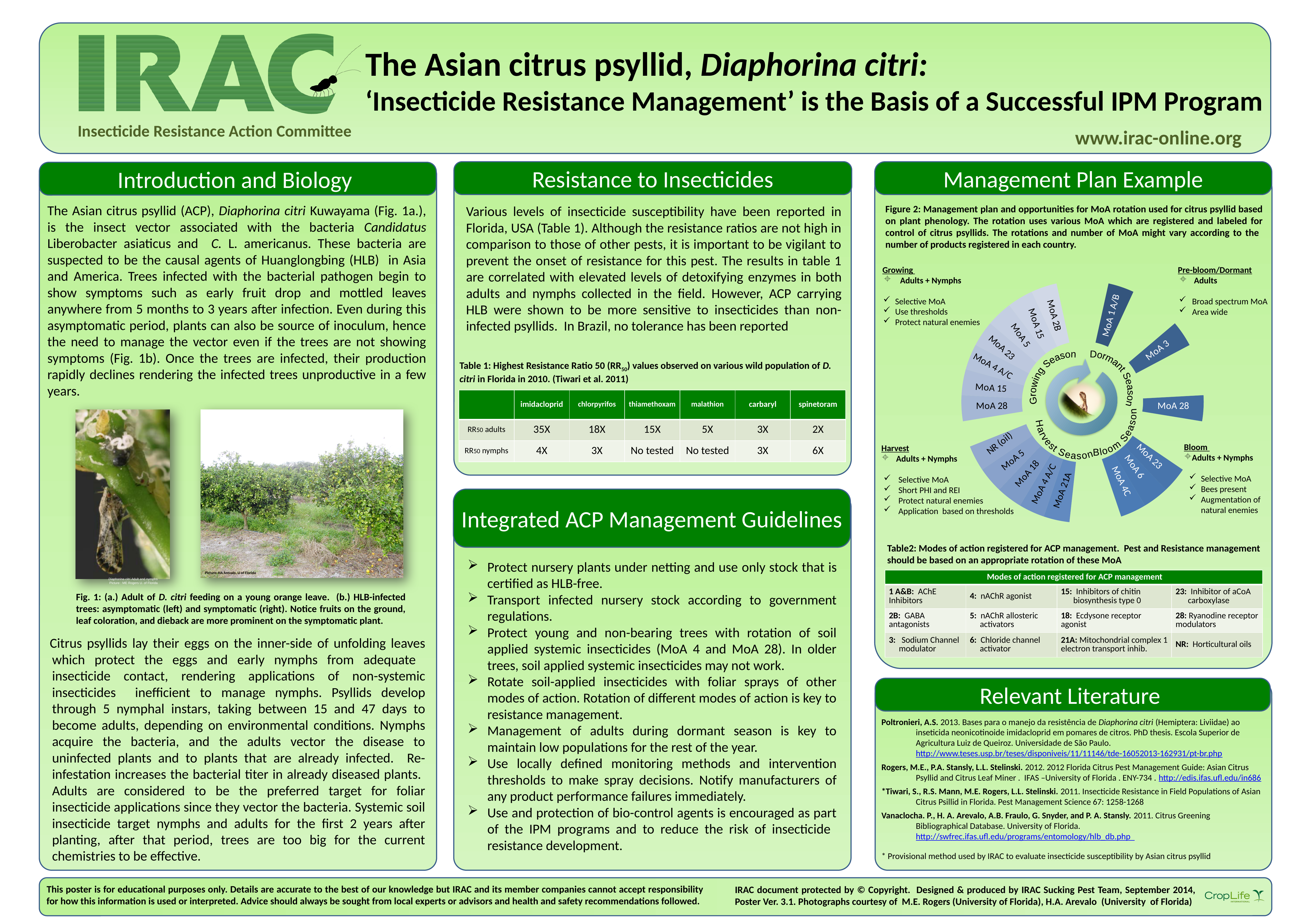
In Table 1, which is larger: the adult RR50 for chlorpyrifos or the adult RR50 for malathion? chlorpyrifos In Table 1, which insecticide has the highest RR50 value for adults? imidacloprid In Table 1, what is the difference between the adult and nymph RR50 values for imidacloprid? 31X In Table 1, what is the RR50 value for spinetoram in nymphs? 6X In Table 1, what is the RR50 value for imidacloprid in adults? 35X In Table 1, which insecticide has the highest RR50 value for nymphs? spinetoram In Table 1, how many insecticides were not tested in nymphs? 2 In Table 1, what is the RR50 value for thiamethoxam in nymphs? No tested In Figure 2, how many seasons are shown around the circular management plan diagram? 4 In Table 1, which insecticide has the lowest RR50 value for adults? spinetoram In Figure 2, which MoA is listed for the Pre-bloom/Dormant season alongside MoA 1A/B and MoA 3? MoA 28 In Table 1, how many insecticides are listed? 6